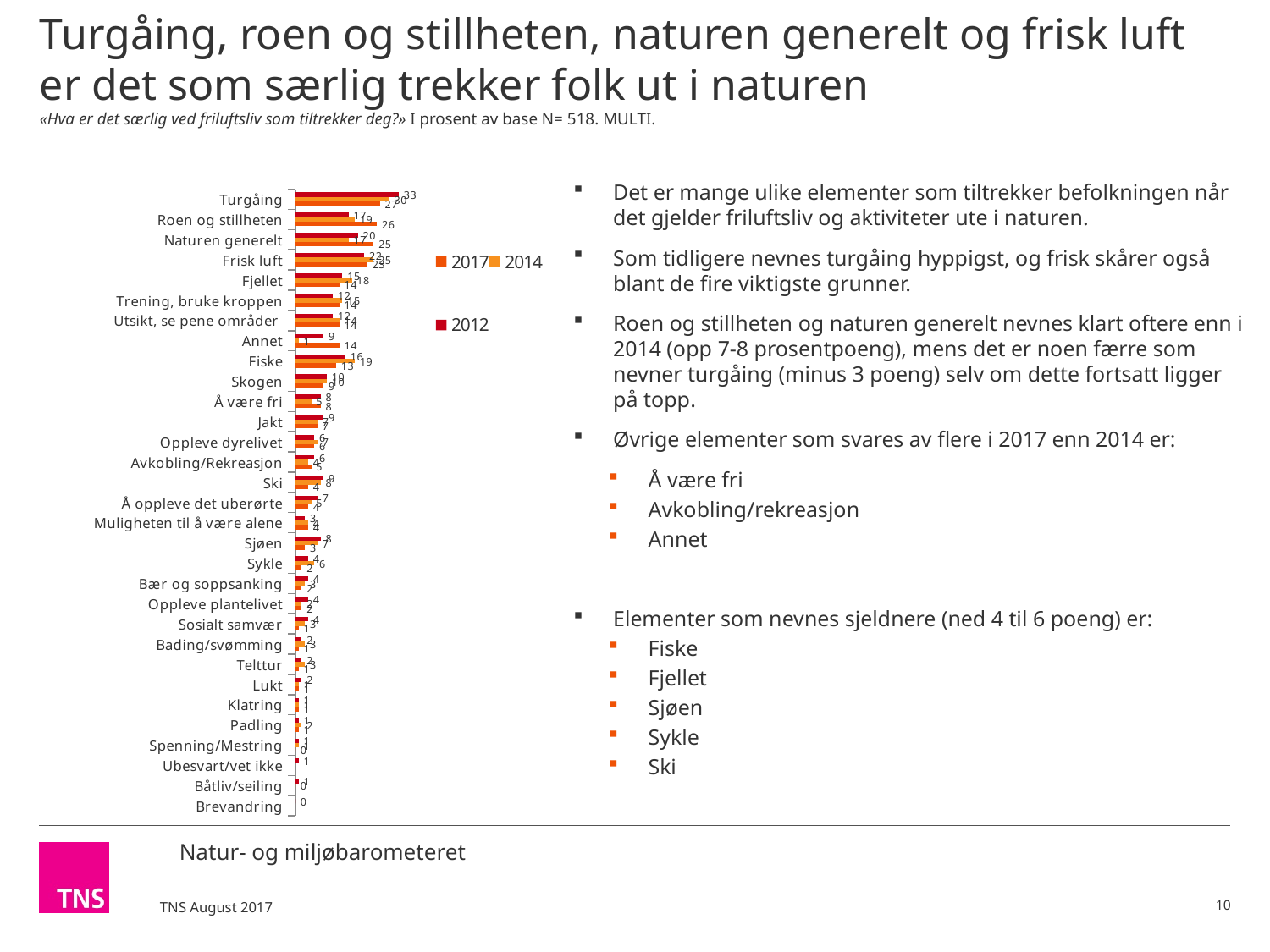
Which category has the lowest value on the chart? Brevandring Which category has the highest values on the chart? Turgåing How many series does the chart legend list? 3 Are the bars in the chart horizontal or vertical? Horizontal Which category has larger values, Turgåing or Brevandring? Turgåing How many categories are plotted on the chart? 31 What kind of chart is shown on the slide? Bar chart What value is shown for Brevandring? 0 Which category is listed at the top of the chart? Turgåing Which category has larger values, Roen og stillheten or Klatring? Roen og stillheten Which years are listed in the chart legend? 2017, 2014, 2012 Which category has larger values, Frisk luft or Padling? Frisk luft